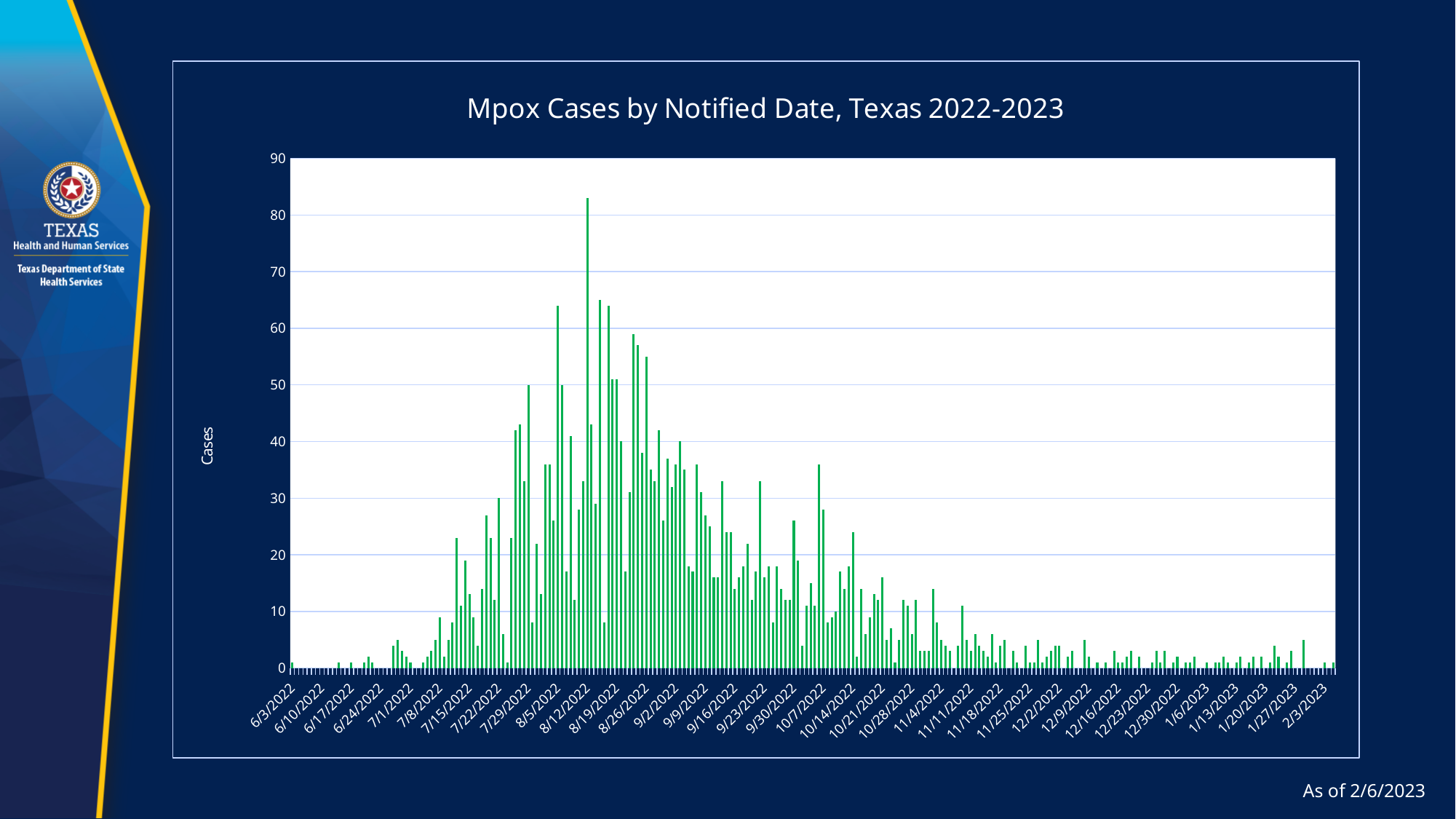
Is the value for 2/3/2023 greater or less than 10? less Do the values generally rise or fall along the x axis from 6/3/2022 to 8/12/2022? Rise Do the values generally rise or fall along the x axis from 8/19/2022 to 2/3/2023? Fall What is the title of the chart? Mpox Cases by Notified Date, Texas 2022-2023 What is the highest value shown on the vertical axis? 90 Is the highest bar in the chart greater or less than 80? greater Is the highest value in January 2023 greater or less than 10? less What is the label on the vertical axis of the chart? Cases What type of chart is shown on the slide? Bar chart In which month does the chart reach its peak number of cases? August 2022 How many data series are plotted in the chart? 1